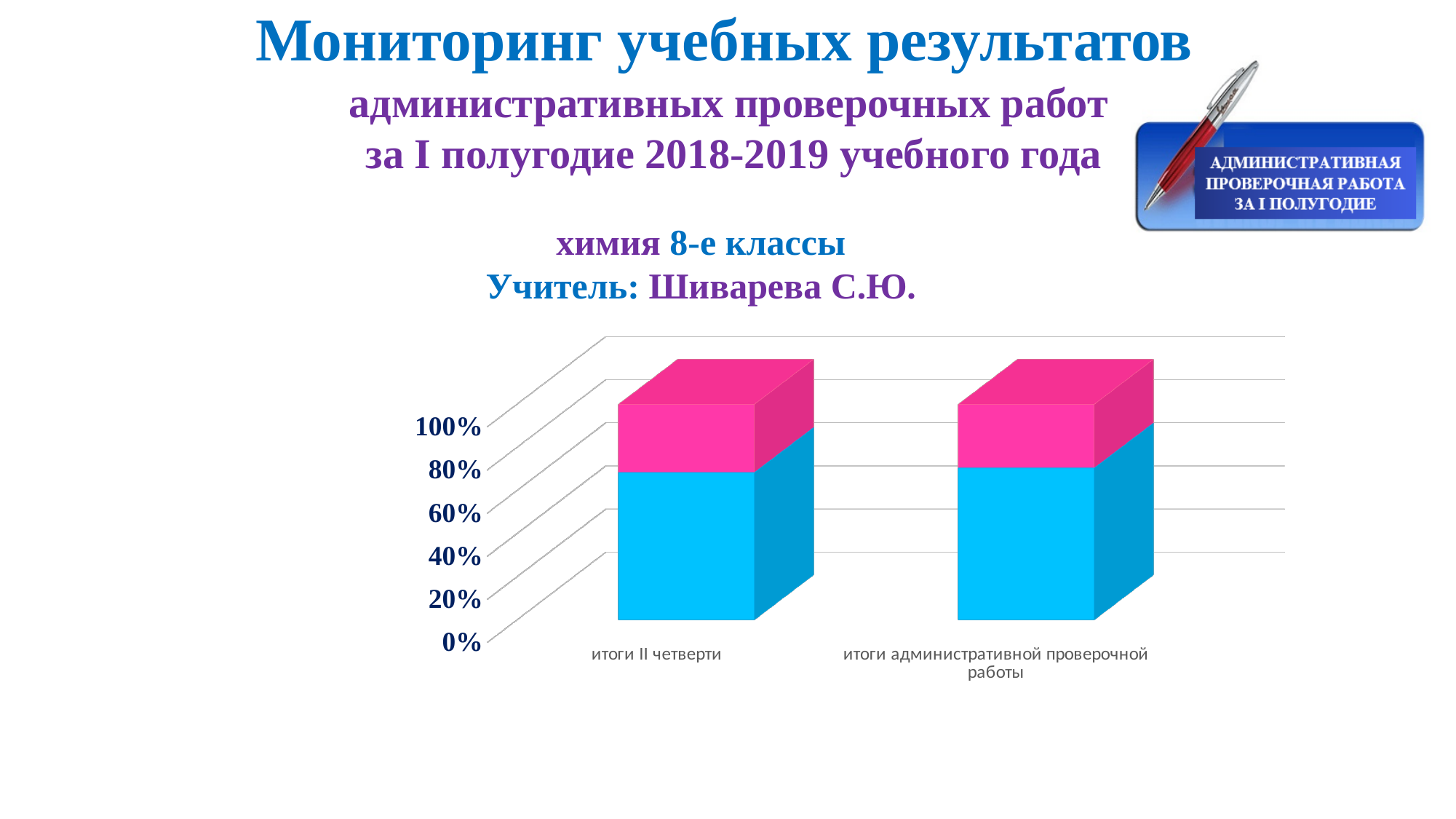
What is the highest value labelled on the vertical axis of the chart? 100% What is the label of the second (right) category on the x axis? итоги административной проверочной работы What is the label of the first (left) category on the x axis? итоги II четверти How many stacked segments does each bar in the chart have? 2 What kind of chart is shown on the slide? bar chart How many categories are shown on the x axis of the chart? 2 Is the blue segment of the bar for 'итоги II четверти' greater or less than 20%? greater Is the blue segment of the bar for 'итоги административной проверочной работы' greater or less than 60%? greater Is the blue segment of the bar for 'итоги административной проверочной работы' greater or less than 40%? greater